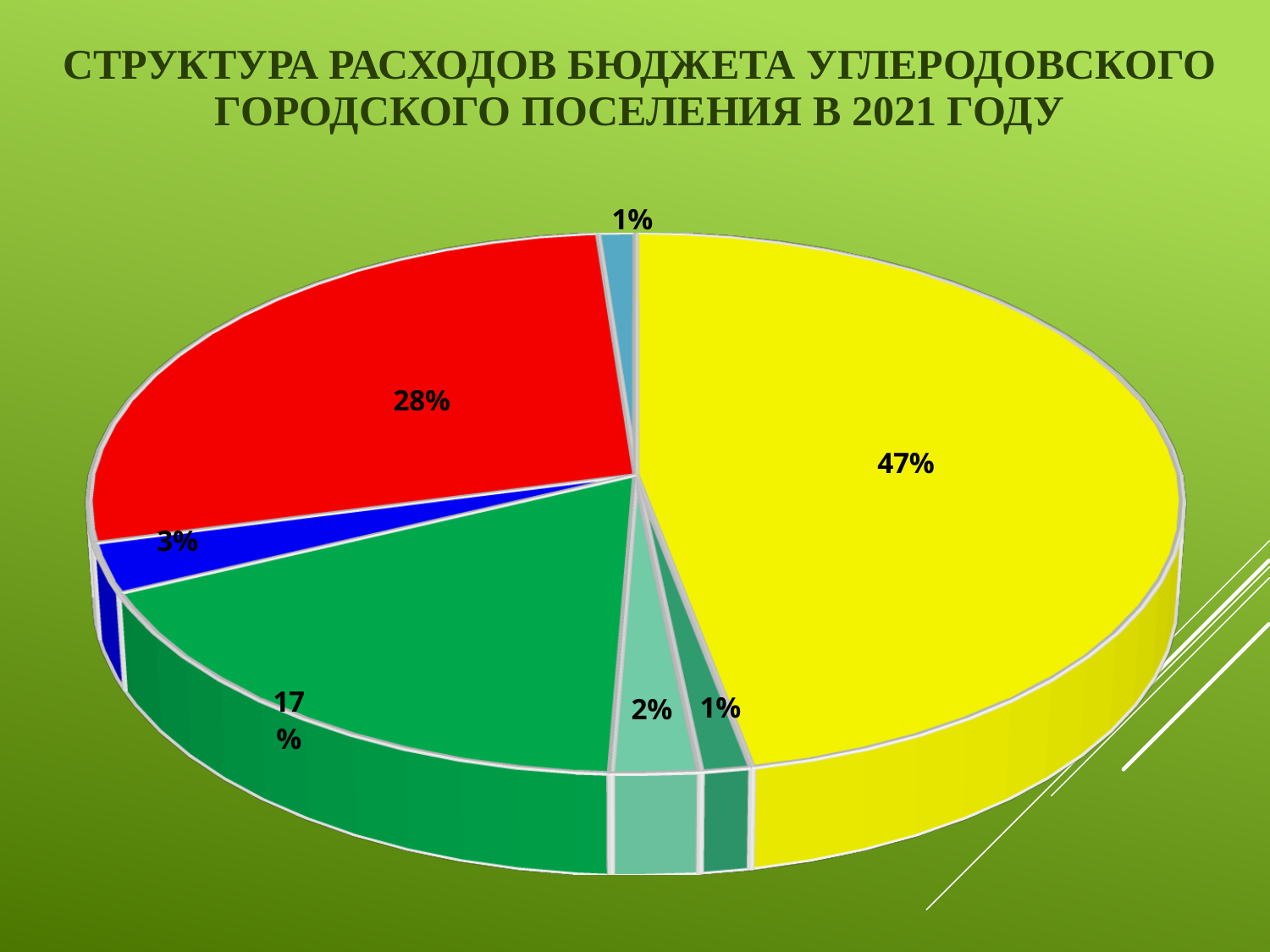
What is the difference between the yellow slice and the red slice of the pie chart? 19% What kind of chart is shown on the slide? pie chart What is the largest share shown in the pie chart? 47% What is the title of the chart on the slide? СТРУКТУРА РАСХОДОВ БЮДЖЕТА УГЛЕРОДОВСКОГО ГОРОДСКОГО ПОСЕЛЕНИЯ В 2021 ГОДУ What percentage is shown on the light green slice at the bottom of the pie chart? 2% What percentage is shown on the blue slice of the pie chart? 3% What percentage is shown on the yellow slice of the pie chart? 47% What percentage is shown on the red slice of the pie chart? 28% Which is larger in the pie chart, the red slice or the dark green slice? red slice What percentage is shown on the large dark green slice of the pie chart? 17% How many slices does the pie chart have? 7 Which colour slice is the largest in the pie chart? yellow